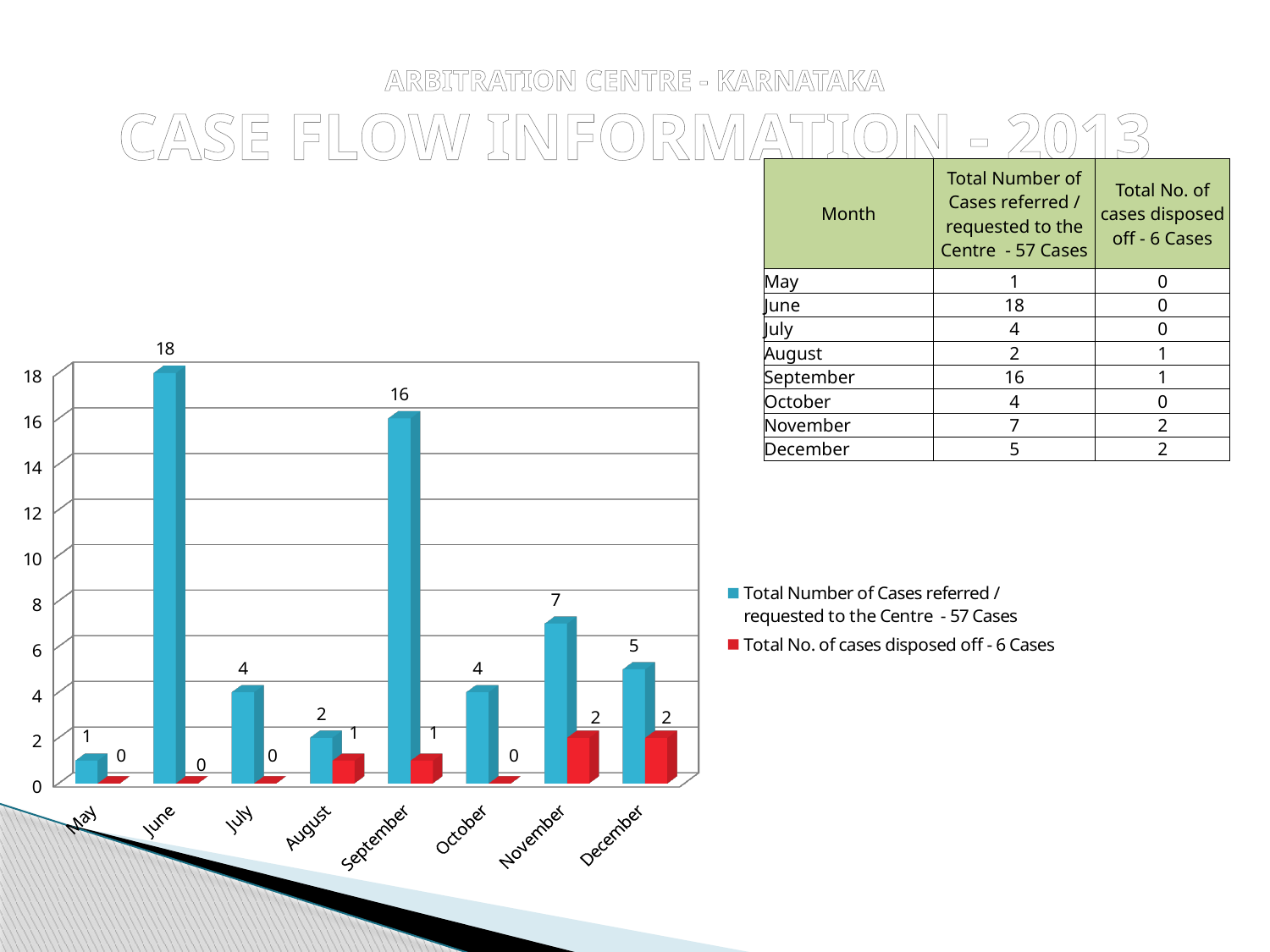
Which month has the lowest number of cases referred / requested to the Centre? May What is the total of cases referred and cases disposed off for December? 7 Which month has the highest number of cases referred / requested to the Centre? June Which is larger: the number of cases referred in November or in December? November Which colour represents the 'Total No. of cases disposed off - 6 Cases' series? red What kind of chart is shown on the slide? bar chart Is the number of cases referred in September greater or less than 10? greater How many cases were disposed off in November? 2 How many cases were referred / requested to the Centre in June? 18 How many months are shown on the x axis of the chart? 8 How many series does the chart legend list? 2 What is the difference between the number of cases referred in June and in September? 2